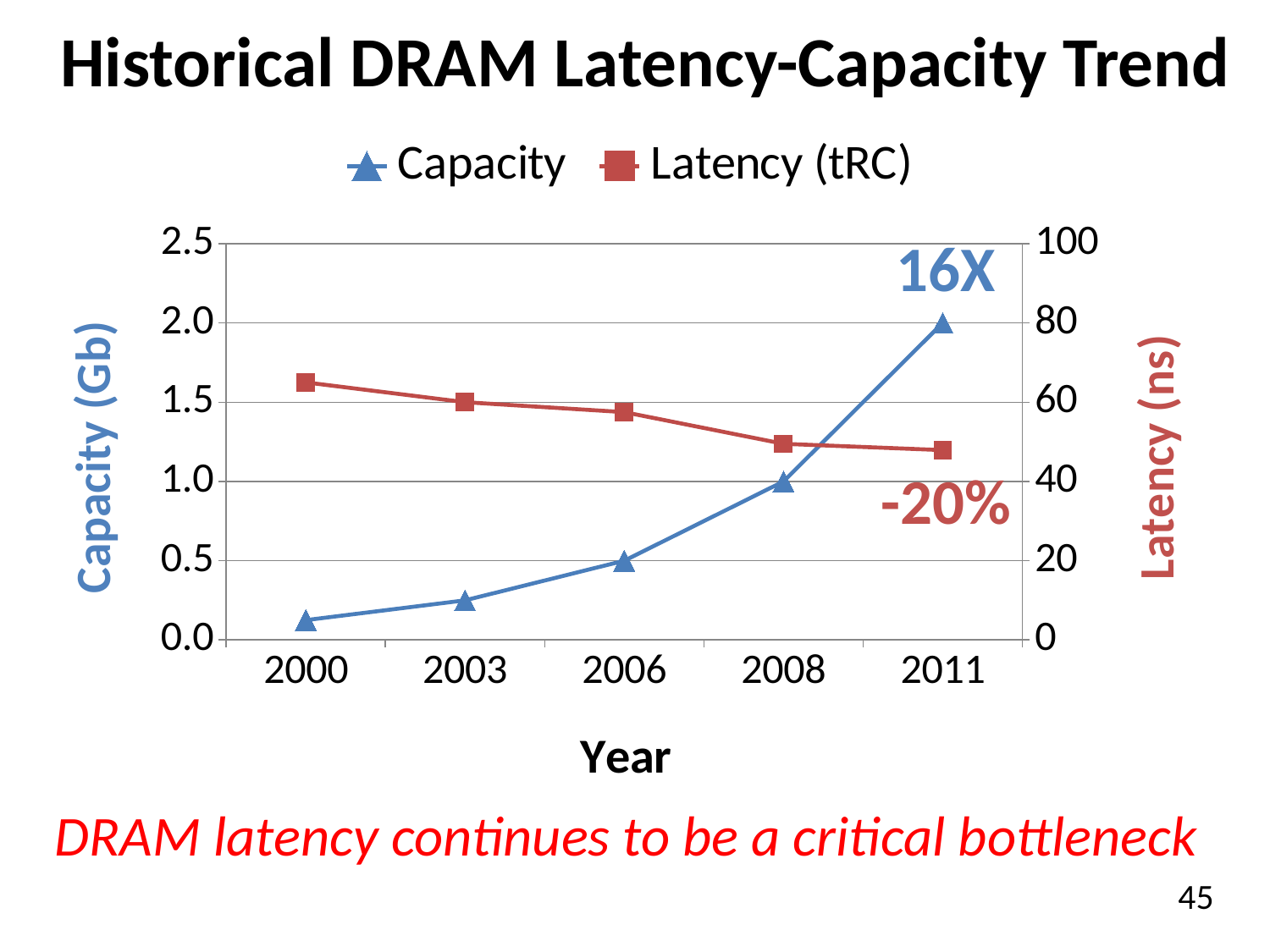
What is the Capacity value in 2011 in Gb? 2.0 Is the Capacity value for 2006 greater or less than 1.0 Gb? less How many series does the legend list? 2 Does the Latency (tRC) series rise or fall from 2000 to 2011? fall In which year is Capacity lowest? 2000 In which year is Capacity highest? 2011 How many years are plotted along the x axis? 5 In which year is Latency (tRC) highest? 2000 Does the Capacity series rise or fall from 2000 to 2011? rise What kind of chart is shown on the slide? line chart Is the Latency (tRC) value for 2000 greater or less than 60 ns? greater What annotation is printed next to the Capacity line near 2011? 16X